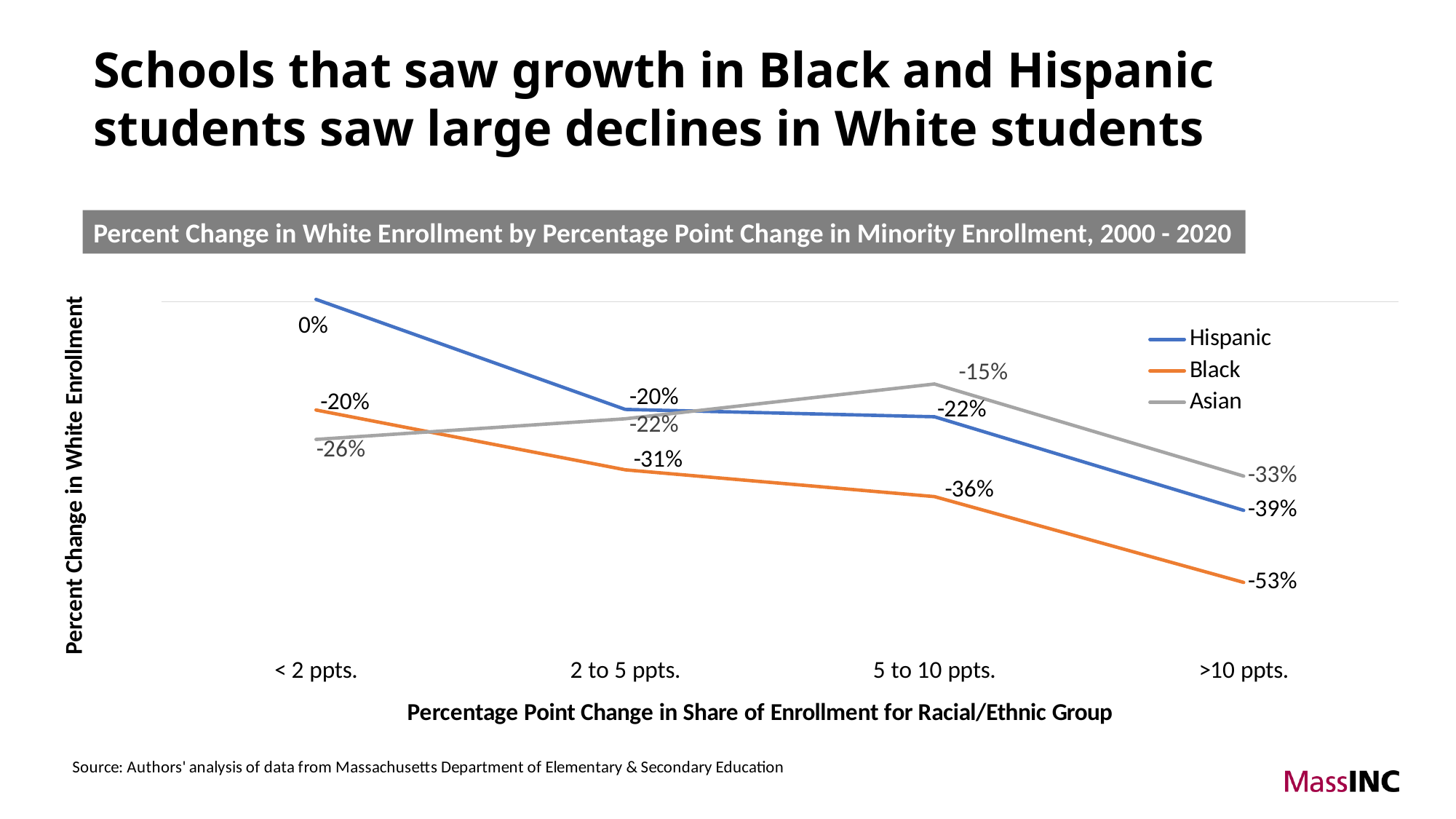
What is the value for Hispanic at '< 2 ppts.'? 0% How many series does the legend list? 3 Which is larger at '2 to 5 ppts.', the Hispanic value or the Black value? Hispanic What is the value for Asian at '5 to 10 ppts.'? -15% How many categories are shown on the x axis? 4 What is the value for Hispanic at '5 to 10 ppts.'? -22% Which series has the highest value at '< 2 ppts.'? Hispanic What is the value for Black at '>10 ppts.'? -53% Which series has the lowest value at '>10 ppts.'? Black What kind of chart is shown on the slide? line chart Does the Black series rise or fall from '< 2 ppts.' to '>10 ppts.'? fall What is the difference between the Hispanic and Black values at '>10 ppts.'? 14 percentage points